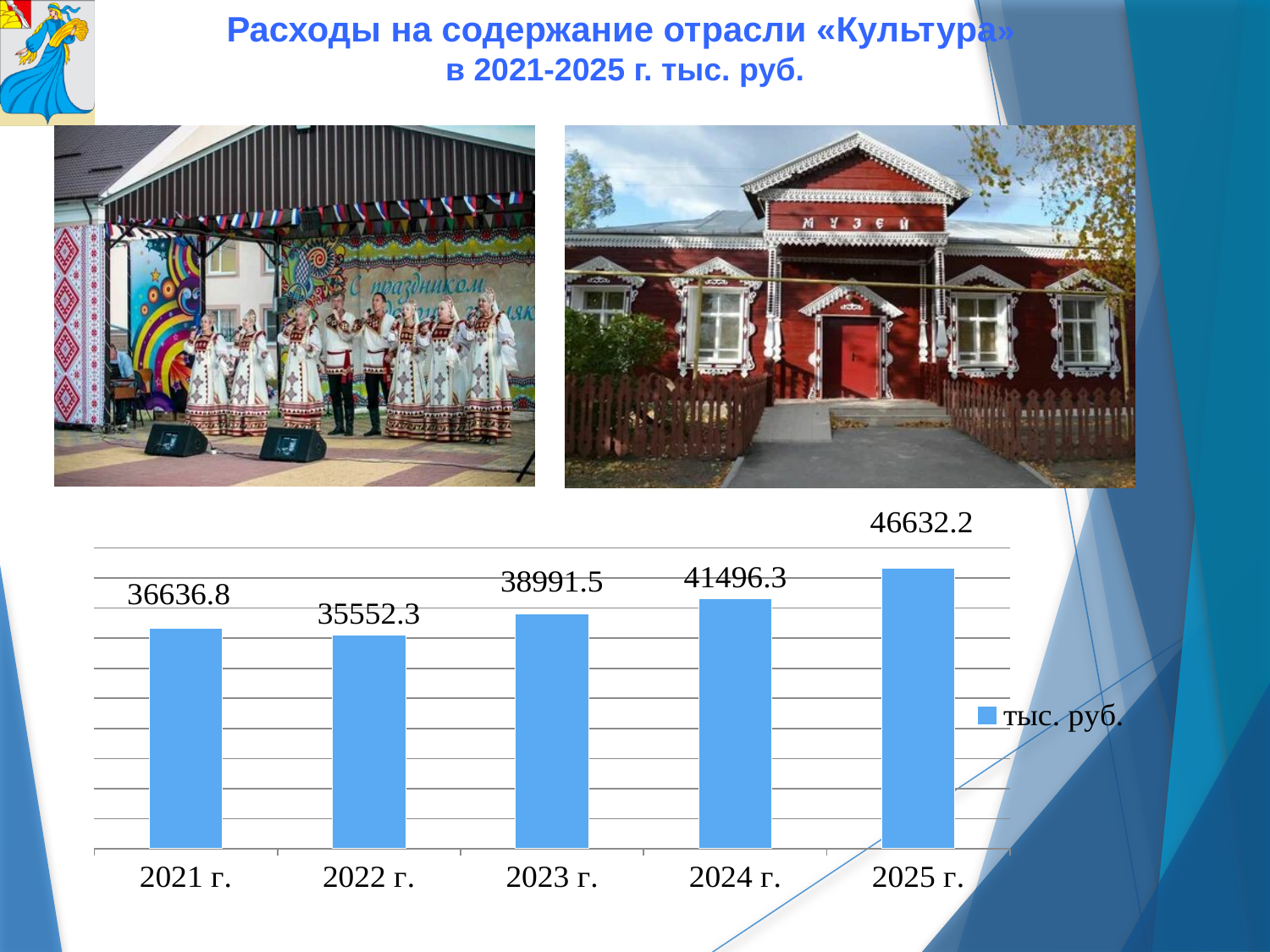
How many series does the legend list? 1 Which is larger, the value for 2021 г. or the value for 2022 г.? 2021 г. What kind of chart is shown? bar chart Which year has the lowest value? 2022 г. How many years are shown on the x axis? 5 What is the value for 2025 г.? 46632.2 What is the value for 2021 г.? 36636.8 Which year has the highest value? 2025 г. What is the value for 2023 г.? 38991.5 Do the values rise or fall from 2022 г. to 2025 г.? rise What is the difference between the values for 2025 г. and 2022 г.? 11079.9 What is the difference between the values for 2024 г. and 2023 г.? 2504.8